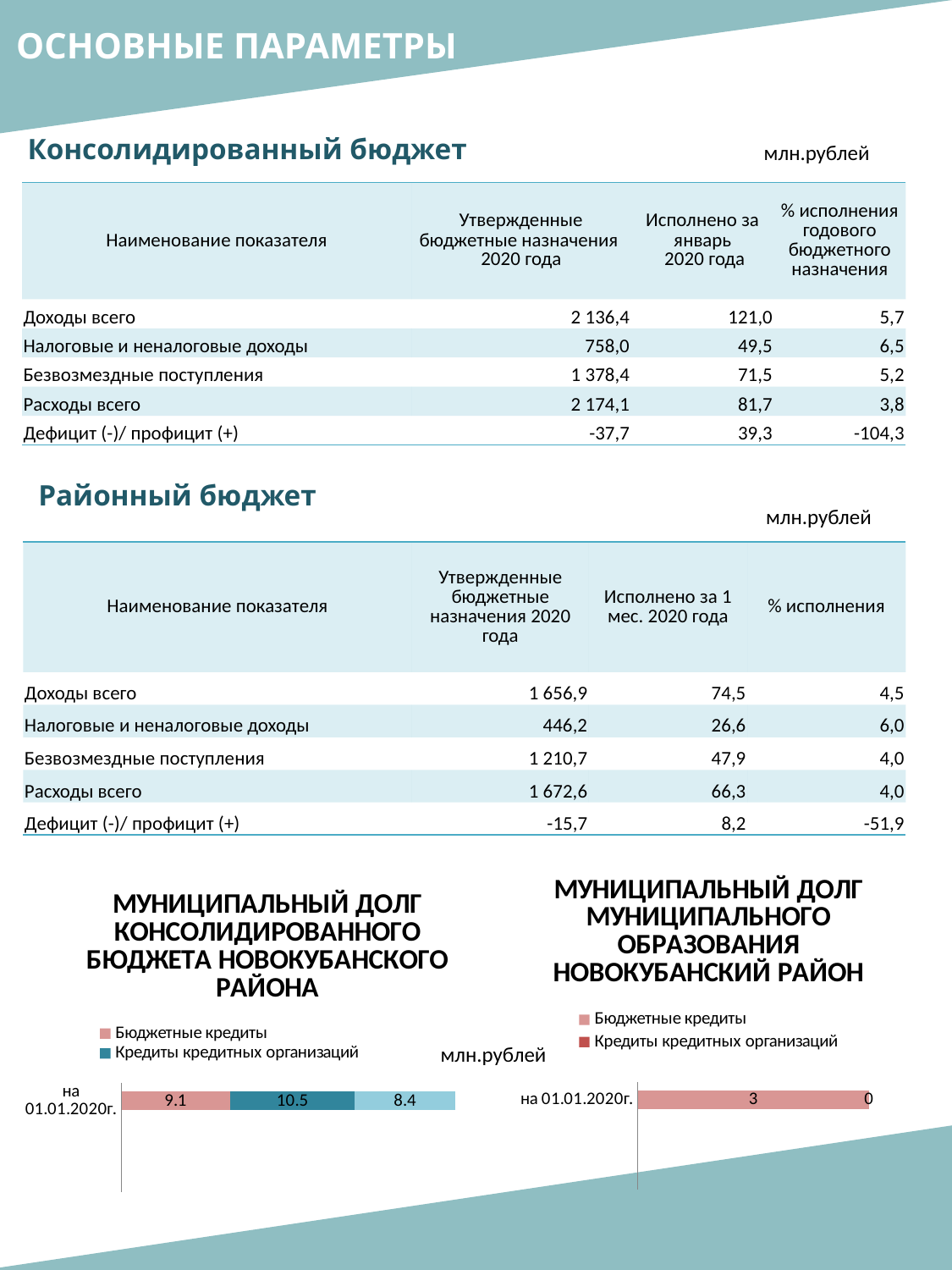
In the chart titled 'МУНИЦИПАЛЬНЫЙ ДОЛГ КОНСОЛИДИРОВАННОГО БЮДЖЕТА НОВОКУБАНСКОГО РАЙОНА', what is the value for Кредиты кредитных организаций? 10.5 What unit is stated for the values in the chart titled 'МУНИЦИПАЛЬНЫЙ ДОЛГ КОНСОЛИДИРОВАННОГО БЮДЖЕТА НОВОКУБАНСКОГО РАЙОНА'? млн.рублей In the chart titled 'МУНИЦИПАЛЬНЫЙ ДОЛГ КОНСОЛИДИРОВАННОГО БЮДЖЕТА НОВОКУБАНСКОГО РАЙОНА', what is the difference between Кредиты кредитных организаций and Бюджетные кредиты? 1.4 In the chart titled 'МУНИЦИПАЛЬНЫЙ ДОЛГ КОНСОЛИДИРОВАННОГО БЮДЖЕТА НОВОКУБАНСКОГО РАЙОНА', which is larger: Бюджетные кредиты or Кредиты кредитных организаций? Кредиты кредитных организаций In the chart titled 'МУНИЦИПАЛЬНЫЙ ДОЛГ МУНИЦИПАЛЬНОГО ОБРАЗОВАНИЯ НОВОКУБАНСКИЙ РАЙОН', what is the value for Кредиты кредитных организаций? 0 In the chart titled 'МУНИЦИПАЛЬНЫЙ ДОЛГ КОНСОЛИДИРОВАННОГО БЮДЖЕТА НОВОКУБАНСКОГО РАЙОНА', what is the total of the stacked bar for 01.01.2020? 28.0 In the chart titled 'МУНИЦИПАЛЬНЫЙ ДОЛГ МУНИЦИПАЛЬНОГО ОБРАЗОВАНИЯ НОВОКУБАНСКИЙ РАЙОН', how many categories are shown on the axis? 1 In the chart titled 'МУНИЦИПАЛЬНЫЙ ДОЛГ КОНСОЛИДИРОВАННОГО БЮДЖЕТА НОВОКУБАНСКОГО РАЙОНА', what is the value for Бюджетные кредиты on 01.01.2020? 9.1 In the chart titled 'МУНИЦИПАЛЬНЫЙ ДОЛГ МУНИЦИПАЛЬНОГО ОБРАЗОВАНИЯ НОВОКУБАНСКИЙ РАЙОН', which series has the higher value? Бюджетные кредиты In the chart titled 'МУНИЦИПАЛЬНЫЙ ДОЛГ МУНИЦИПАЛЬНОГО ОБРАЗОВАНИЯ НОВОКУБАНСКИЙ РАЙОН', what is the value for Бюджетные кредиты on 01.01.2020? 3 In the chart titled 'МУНИЦИПАЛЬНЫЙ ДОЛГ КОНСОЛИДИРОВАННОГО БЮДЖЕТА НОВОКУБАНСКОГО РАЙОНА', how many series does the legend list? 2 What kind of chart is the one titled 'МУНИЦИПАЛЬНЫЙ ДОЛГ КОНСОЛИДИРОВАННОГО БЮДЖЕТА НОВОКУБАНСКОГО РАЙОНА'? Bar chart